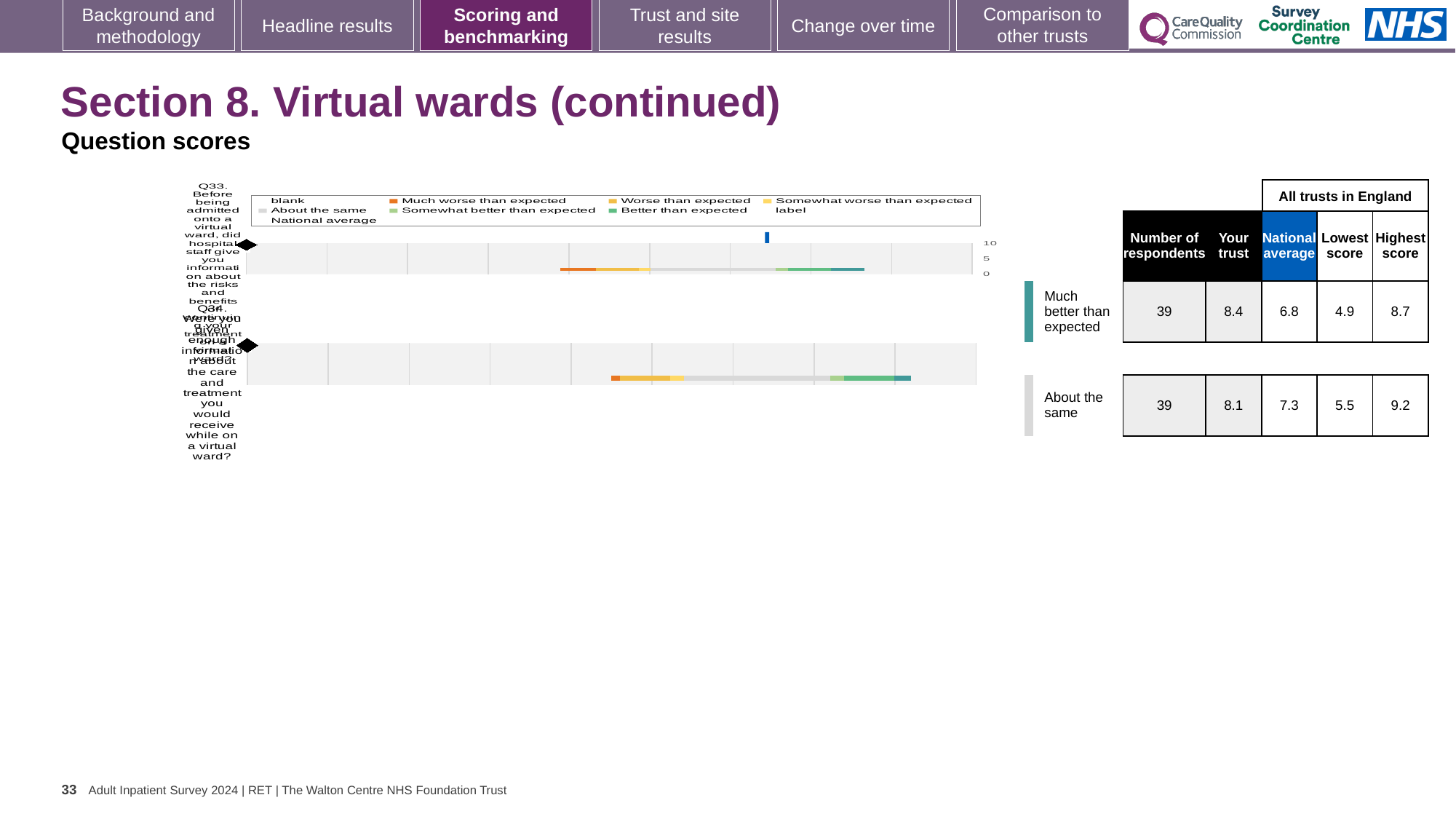
By how much does the trust's score for Q33 exceed the national average? 1.6 How many respondents answered Q33? 39 What is the 'Your trust' score for Q33? 8.4 What is the lowest score across all trusts in England for Q33? 4.9 What benchmark category is the trust's Q34 score placed in? About the same Which question has the higher 'Your trust' score, Q33 or Q34? Q33 How many questions (rows) are plotted in the chart? 2 What is the difference between the highest and lowest scores for Q34? 3.7 What kind of chart is shown on the slide? bar chart What benchmark category is the trust's Q33 score placed in? Much better than expected What is the national average score for Q34? 7.3 What is the highest score across all trusts in England for Q34? 9.2